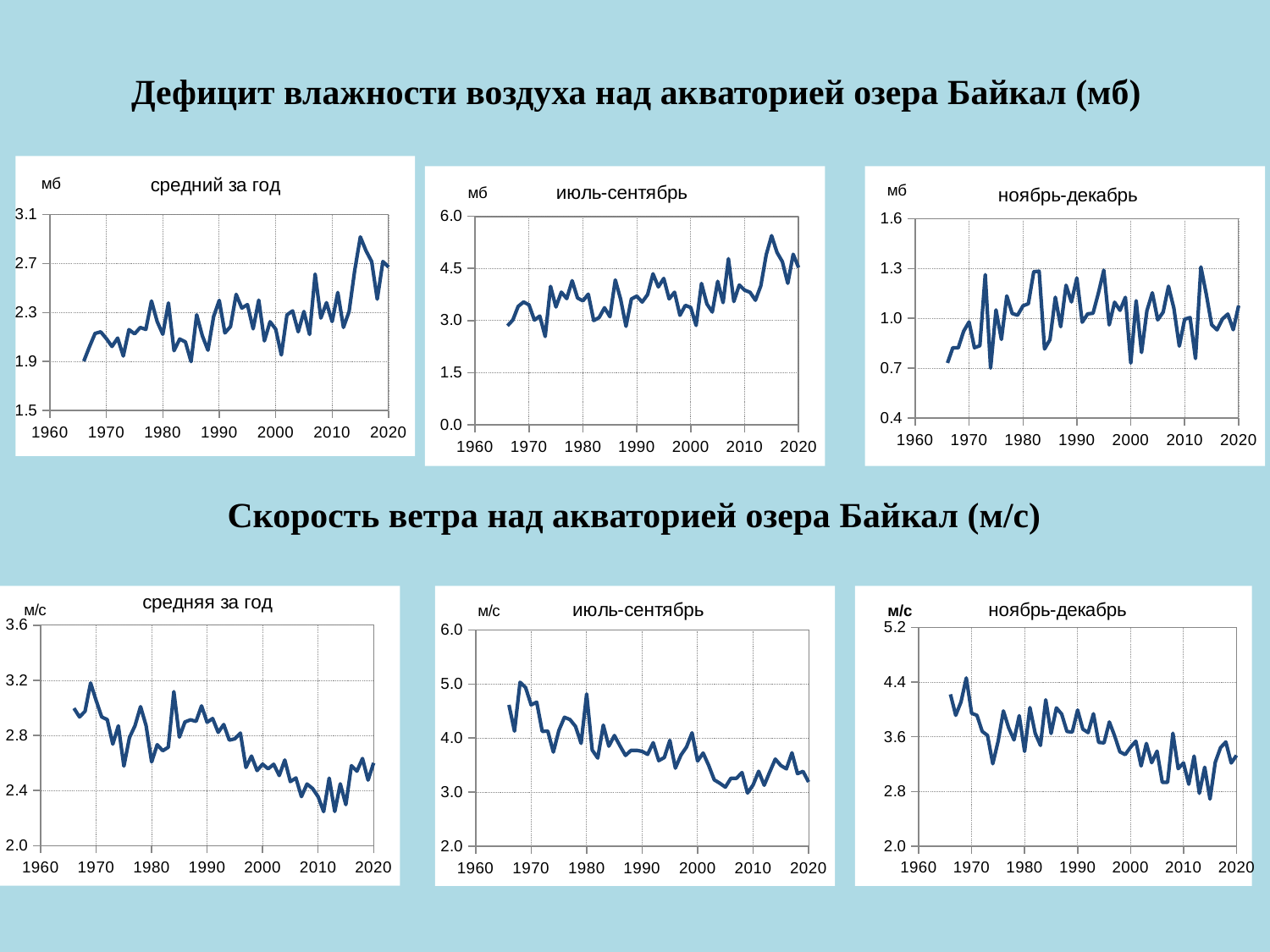
In the bottom-left chart "средняя за год" (wind speed), is the lowest value around 2011 greater or less than 2.4? less In the top-middle chart "июль-сентябрь" (humidity deficit), is the peak value around 2015 greater or less than 4.5? greater In the bottom-middle chart "июль-сентябрь" (wind speed), is the value at the 1980 peak greater or less than 4.0? greater In the top-left chart "средний за год" (humidity deficit), do the values generally rise or fall from 1960 to 2020? rise In the bottom-middle chart "июль-сентябрь" (wind speed), do the values generally rise or fall over the period shown? fall In the bottom-left chart "средняя за год" (wind speed), do the values generally rise or fall from 1960 to 2020? fall What kind of chart is the top-left chart titled "средний за год"? line chart What unit is shown on the y axis of the bottom row of charts (wind speed)? м/с How many charts are shown on the slide? 6